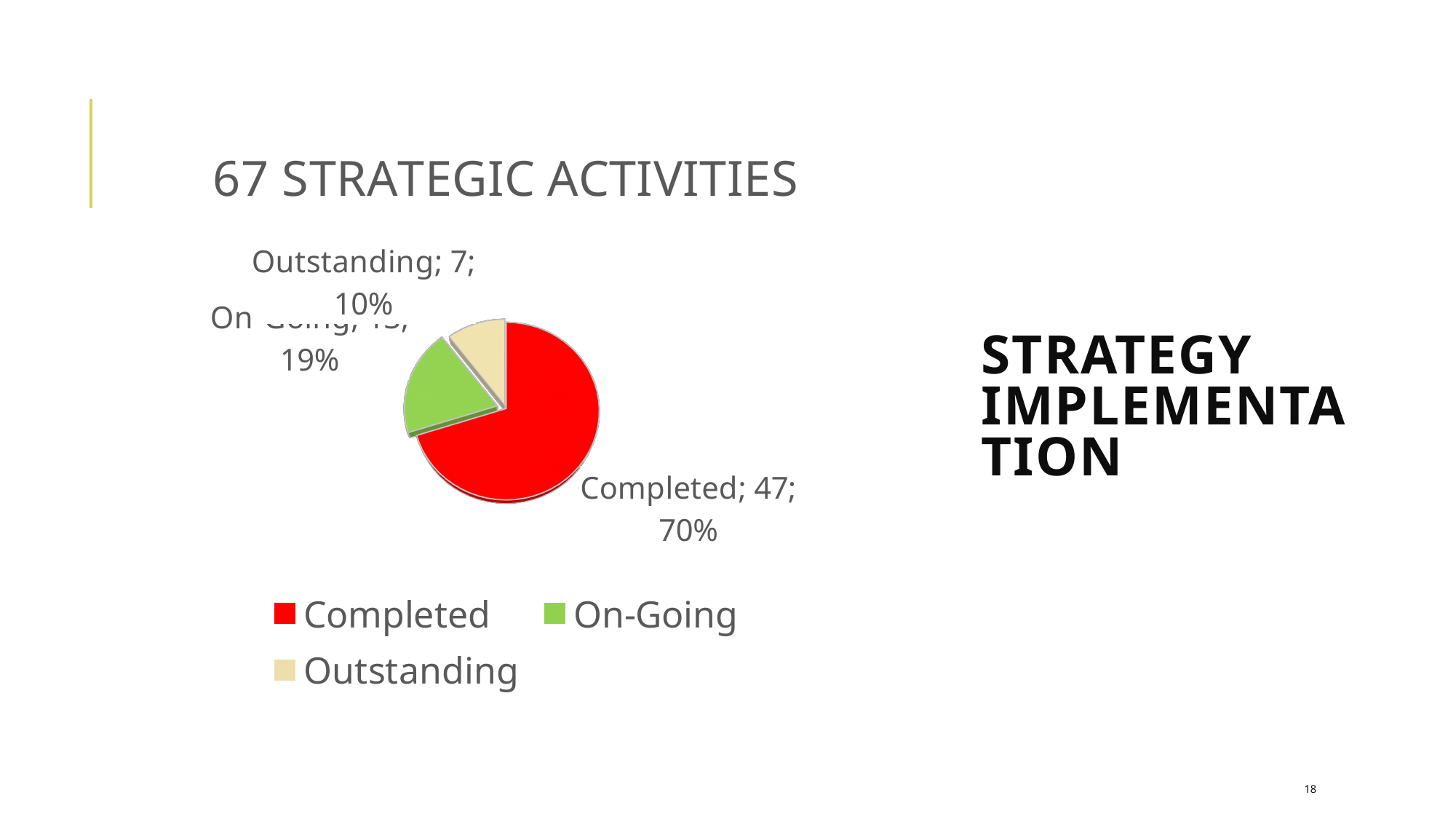
How many entries does the legend of the pie chart list? 3 What is the difference between the number of Completed activities and the number of Outstanding activities? 40 What percentage share of the pie does the On-Going slice have? 19% What percentage share of the pie does the Outstanding slice have? 10% Which category has the smallest slice in the pie chart? Outstanding How many activities are labelled as Outstanding in the pie chart? 7 Which category has the largest slice in the pie chart? Completed How many activities are labelled as Completed in the pie chart? 47 What percentage share of the pie does the Completed slice have? 70% How many slices does the pie chart have? 3 What kind of chart is shown on the slide? Pie chart What is the title of the chart on the slide? 67 STRATEGIC ACTIVITIES